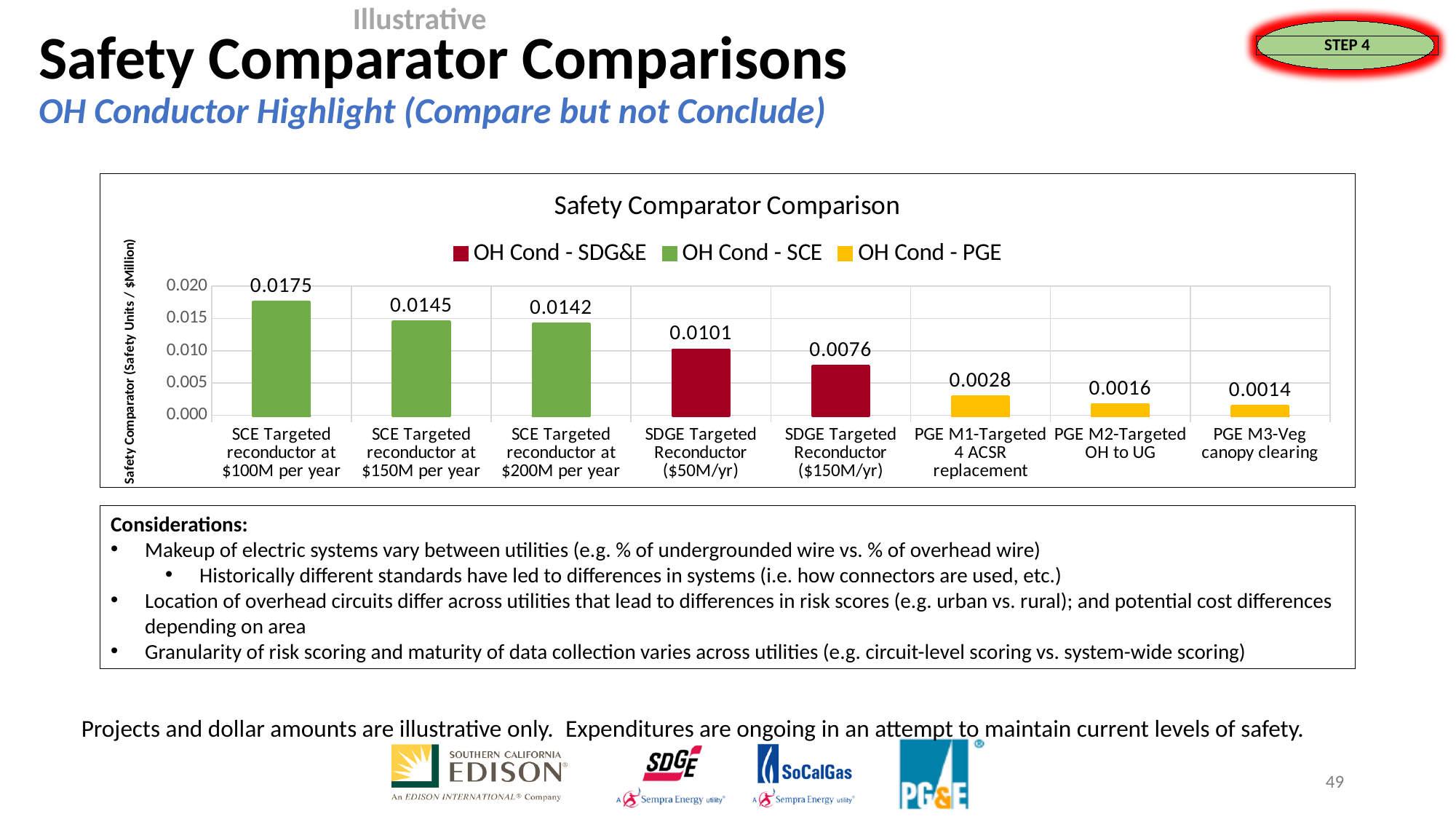
How many categories are shown on the x axis? 8 Which category has the highest value? SCE Targeted reconductor at $100M per year What is the title of the chart? Safety Comparator Comparison What is the value for PGE M3-Veg canopy clearing? 0.0014 What is the difference between SCE Targeted reconductor at $100M per year and SCE Targeted reconductor at $150M per year? 0.0030 Which category has the lowest value? PGE M3-Veg canopy clearing Which is larger: SDGE Targeted Reconductor ($150M/yr) or PGE M1-Targeted 4 ACSR replacement? SDGE Targeted Reconductor ($150M/yr) What kind of chart is shown? Bar chart What is the value for SCE Targeted reconductor at $100M per year? 0.0175 How many series does the legend list? 3 What is the difference between SDGE Targeted Reconductor ($50M/yr) and SDGE Targeted Reconductor ($150M/yr)? 0.0025 What is the value for SDGE Targeted Reconductor ($50M/yr)? 0.0101